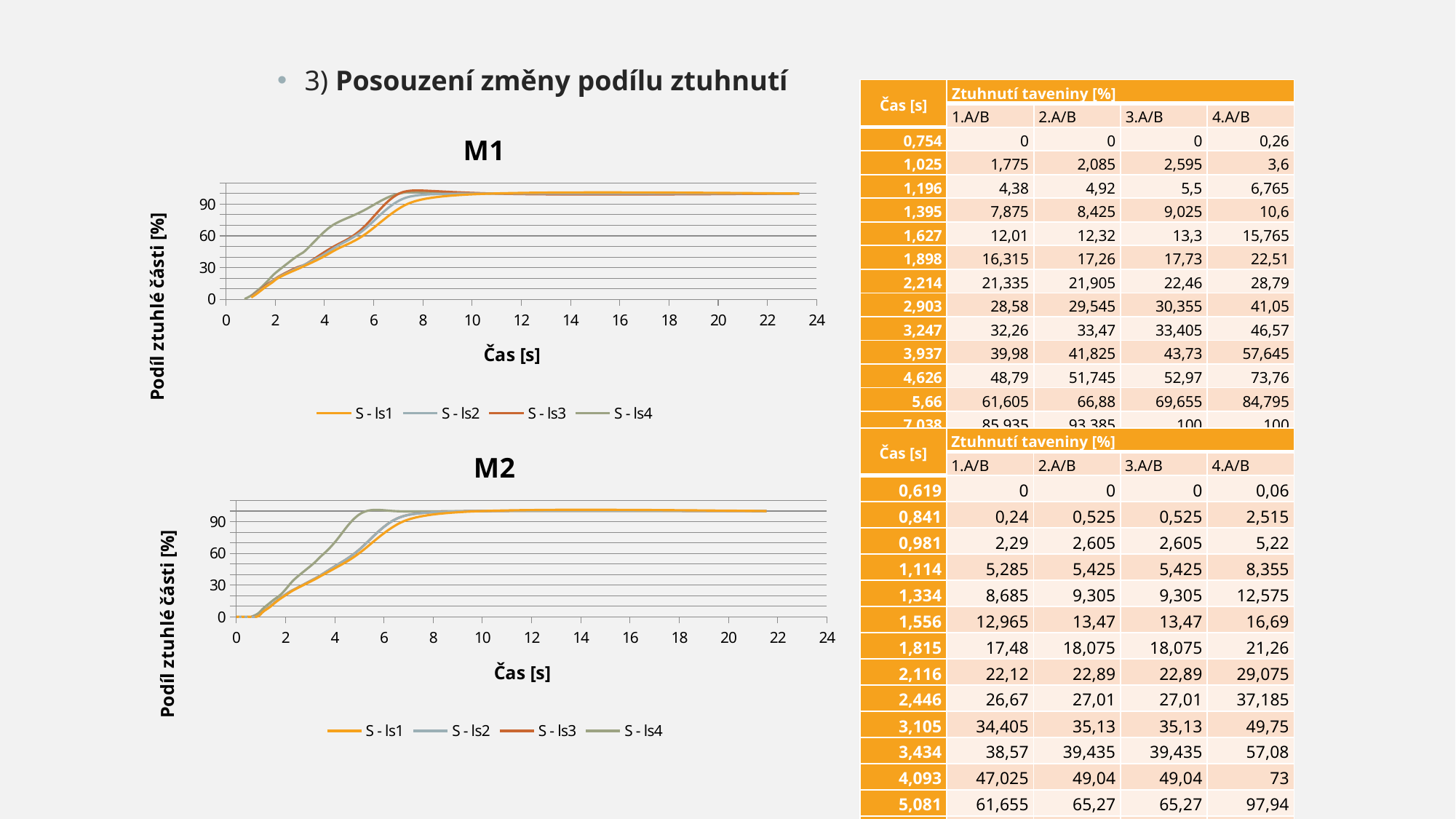
In the M1 chart, which series reaches a higher value at 4 s, S - ls4 or S - ls1? S - ls4 What is the largest tick value shown on the x axis of the M1 chart? 24 In the M2 chart, do the values of S - ls2 rise or fall between 10 s and 20 s? neither, they stay flat In the M1 chart, do the values of S - ls1 rise or fall as time increases from 0 to 8 s? rise How many series does the legend of the M2 chart list? 4 In the M2 chart, is the value of S - ls4 at 6 s greater or less than 90? greater In the M2 chart, is the value of S - ls1 at 4 s greater or less than 60? less What are the legend entries of the M1 chart? S - ls1, S - ls2, S - ls3, S - ls4 What kind of chart is the M1 chart? line chart What is the x-axis title of the M2 chart? Čas [s] In the M2 chart, which series has the highest value at 4 s? S - ls4 In the M1 chart, is the value of S - ls1 at 2 s greater or less than 30? less